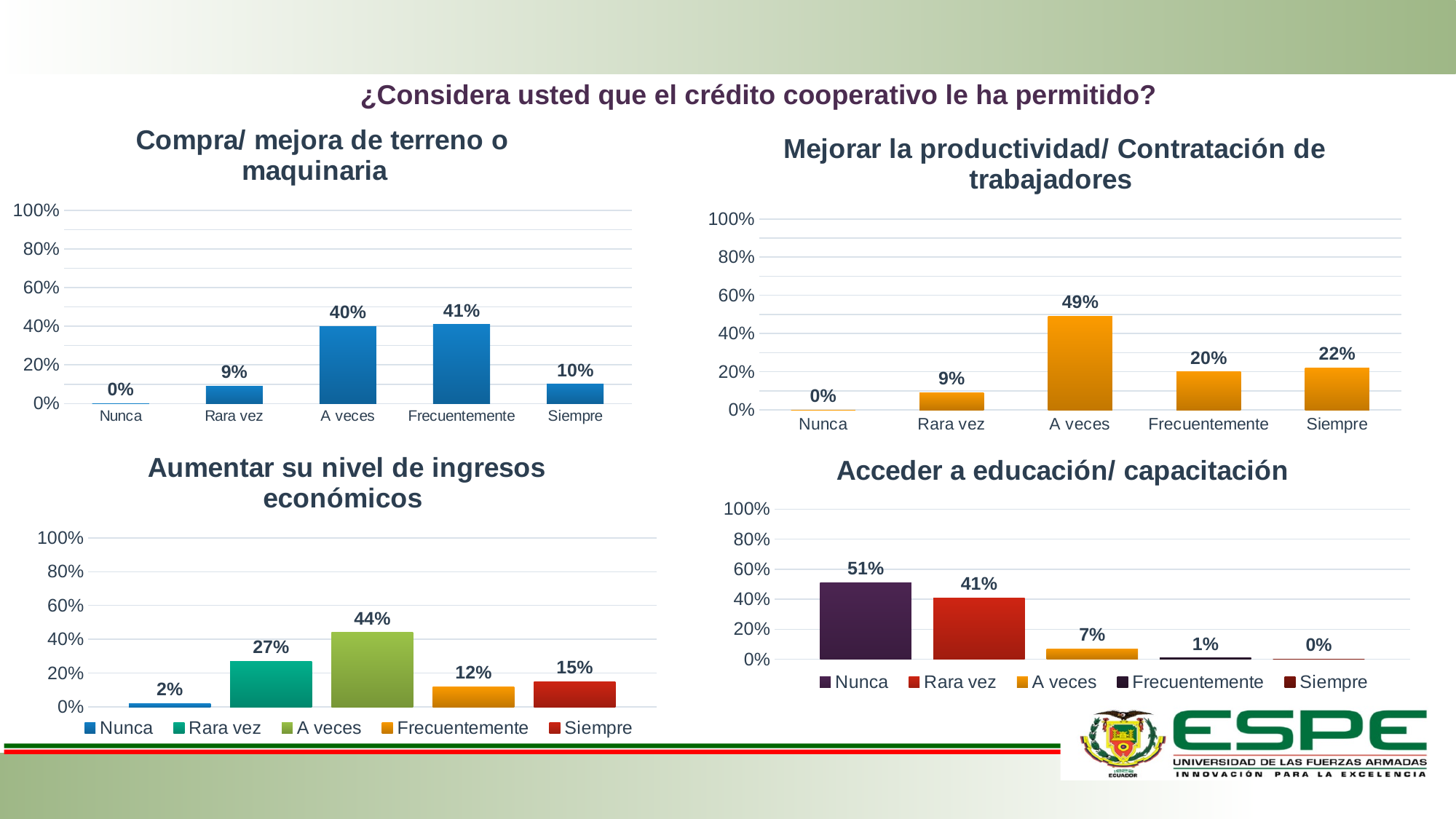
In the chart titled 'Acceder a educación/ capacitación', do the values rise or fall from Nunca to Siempre? Fall In the chart titled 'Acceder a educación/ capacitación', what is the difference between Nunca and Rara vez? 10% In the chart titled 'Mejorar la productividad/ Contratación de trabajadores', which category has the highest value? A veces In the chart titled 'Aumentar su nivel de ingresos económicos', which category has the lowest value? Nunca What kind of chart is the chart titled 'Mejorar la productividad/ Contratación de trabajadores'? Bar chart In the chart titled 'Aumentar su nivel de ingresos económicos', which is larger, Frecuentemente or Siempre? Siempre In the chart titled 'Aumentar su nivel de ingresos económicos', what is the value for Rara vez? 27% In the chart titled 'Mejorar la productividad/ Contratación de trabajadores', what is the value for Siempre? 22% In the chart titled 'Compra/ mejora de terreno o maquinaria', what is the value for Frecuentemente? 41% How many entries does the legend of the chart titled 'Acceder a educación/ capacitación' list? 5 In the chart titled 'Acceder a educación/ capacitación', what is the value for Nunca? 51% In the chart titled 'Compra/ mejora de terreno o maquinaria', how many categories are shown on the x axis? 5